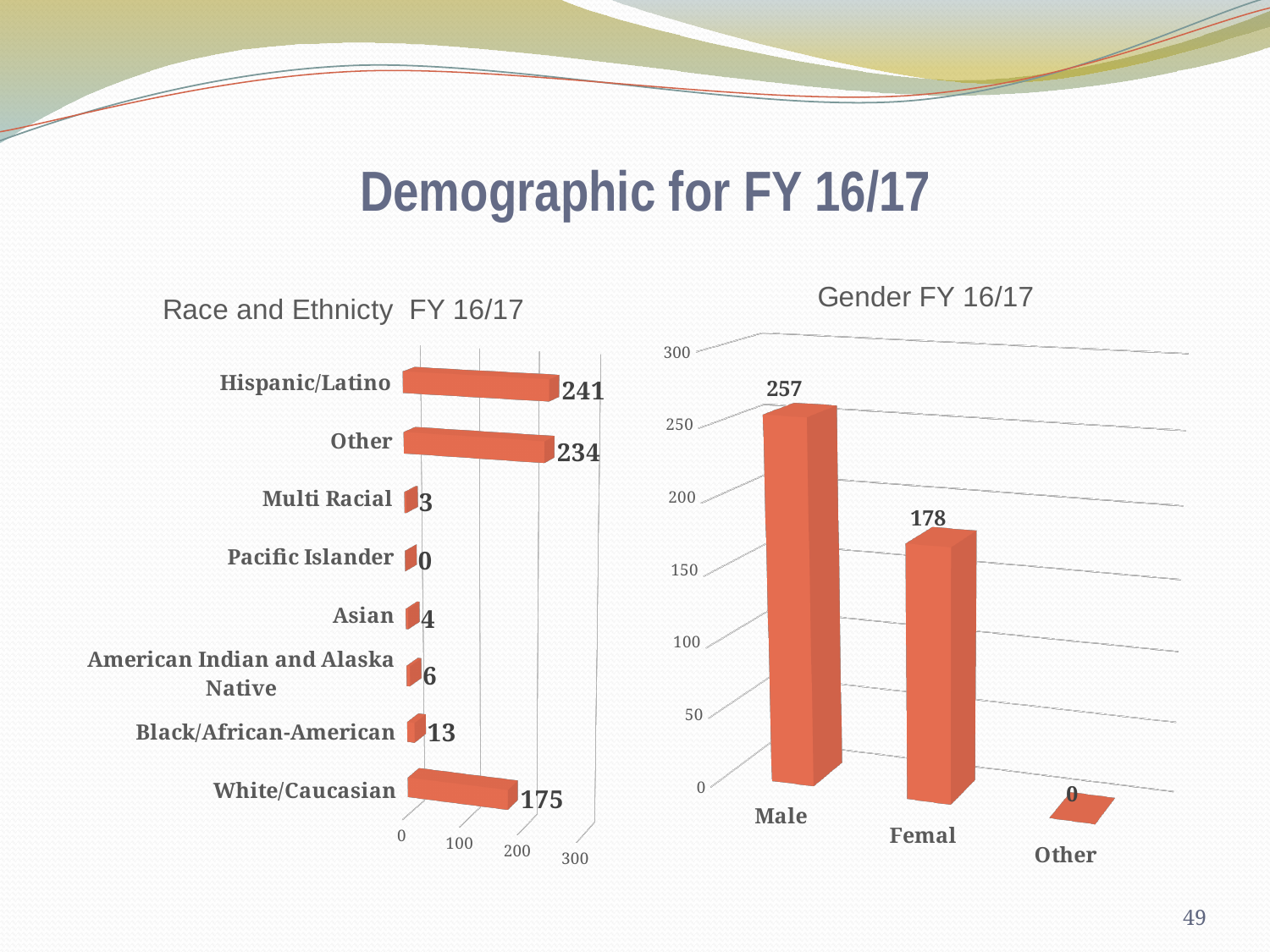
In the 'Race and Ethnicty FY 16/17' chart, which category has the lowest value? Pacific Islander In the 'Gender FY 16/17' chart, what is the value for Male? 257 In the 'Race and Ethnicty FY 16/17' chart, which category has the highest value? Hispanic/Latino In the 'Race and Ethnicty FY 16/17' chart, what is the difference between the values for Hispanic/Latino and Other? 7 In the 'Race and Ethnicty FY 16/17' chart, which is larger, the value for Black/African-American or the value for Asian? Black/African-American What kind of chart is the 'Gender FY 16/17' chart? Bar chart In the 'Gender FY 16/17' chart, how many categories are shown? 3 In the 'Race and Ethnicty FY 16/17' chart, how many categories are shown? 8 In the 'Gender FY 16/17' chart, what is the value for Femal? 178 In the 'Race and Ethnicty FY 16/17' chart, what is the value for Hispanic/Latino? 241 In the 'Race and Ethnicty FY 16/17' chart, what is the value for White/Caucasian? 175 In the 'Gender FY 16/17' chart, what is the difference between the values for Male and Femal? 79